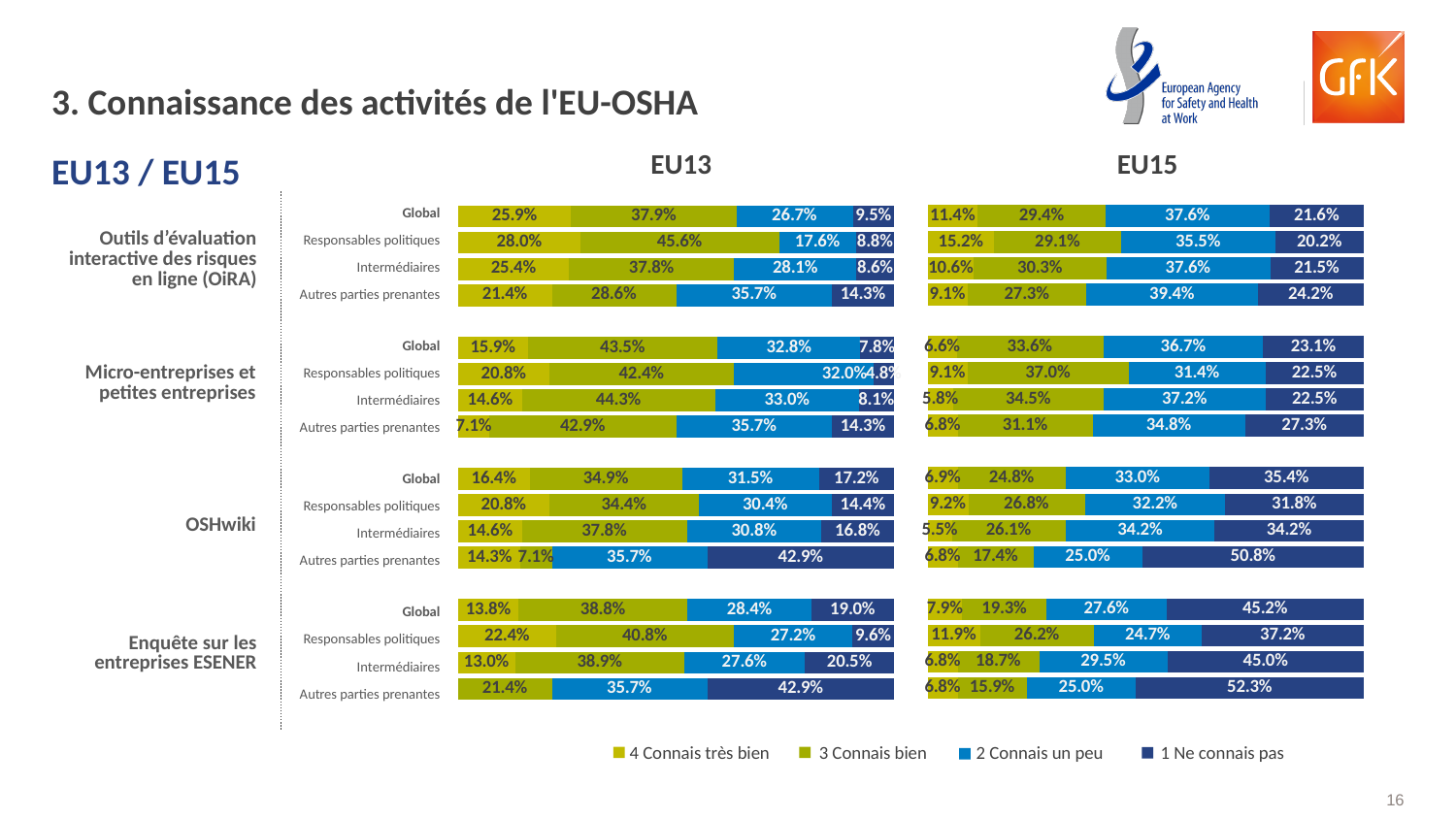
How many series does the legend list? 4 What type of chart is used for the EU13 and EU15 panels on this slide? Stacked bar chart What is the difference between the '1 Ne connais pas' value for the OSHwiki Global row in the EU15 chart (35.4%) and in the EU13 chart (17.2%)? 18.2 percentage points In the EU13 chart, what is the '3 Connais bien' value for 'Responsables politiques' in the 'Micro-entreprises et petites entreprises' section? 42.4% What are the four legend entries shown below the charts? 4 Connais très bien, 3 Connais bien, 2 Connais un peu, 1 Ne connais pas In the EU13 chart, which row of the OiRA section has the lowest '4 Connais très bien' value? Autres parties prenantes For the Global row of OiRA, is the '3 Connais bien' value larger in the EU13 chart or the EU15 chart? EU13 In the EU13 chart, how many rows (respondent groups) are shown in each section? 4 In the EU15 chart, what is the '1 Ne connais pas' value for 'Autres parties prenantes' in the 'Enquête sur les entreprises ESENER' section? 52.3% In the EU15 chart, which row of the 'Enquête sur les entreprises ESENER' section has the highest '1 Ne connais pas' value? Autres parties prenantes In the EU13 chart, what is the '4 Connais très bien' value for the Global row of 'Outils d'évaluation interactive des risques en ligne (OiRA)'? 25.9% In the EU15 chart, what is the '2 Connais un peu' value for 'Intermédiaires' in the OSHwiki section? 34.2%